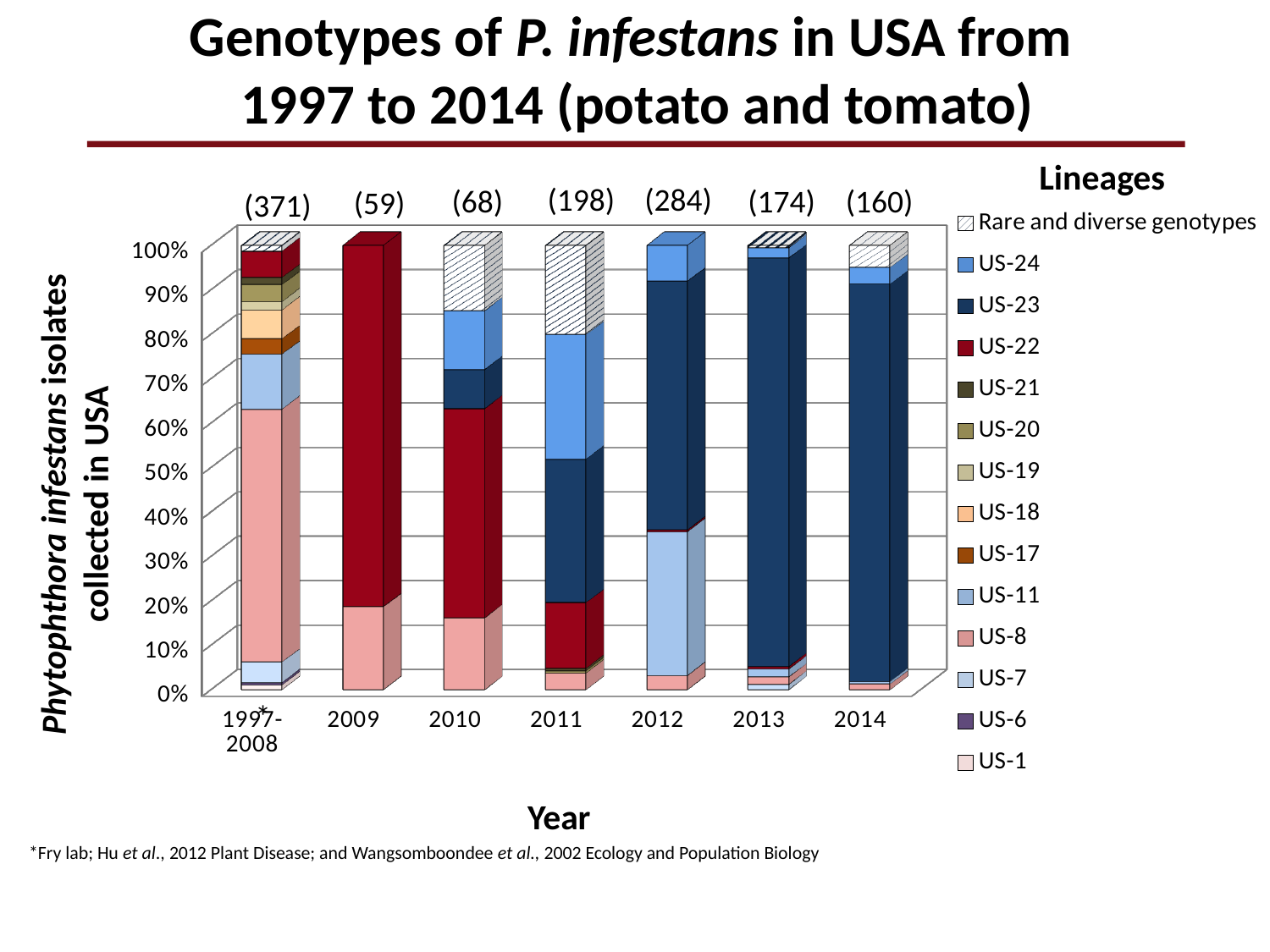
What kind of chart is shown on the slide? Stacked bar chart How many year categories are shown on the x axis? 7 What is the title of the x axis? Year Which has more isolates in parentheses above its bar, 2011 or 2012? 2012 What is the number of isolates shown in parentheses above the 1997-2008 bar? 371 What is the difference between the number of isolates for 1997-2008 (371) and for 2009 (59)? 312 What is the number of isolates shown in parentheses above the 2012 bar? 284 How many lineages does the legend list? 14 Which year has the largest number of isolates shown in parentheses above its bar? 1997-2008 Is the share of US-23 in the 2013 bar greater or less than 80%? greater Which year has the smallest number of isolates shown in parentheses above its bar? 2009 Is the share of US-22 in the 2009 bar greater or less than 70%? greater